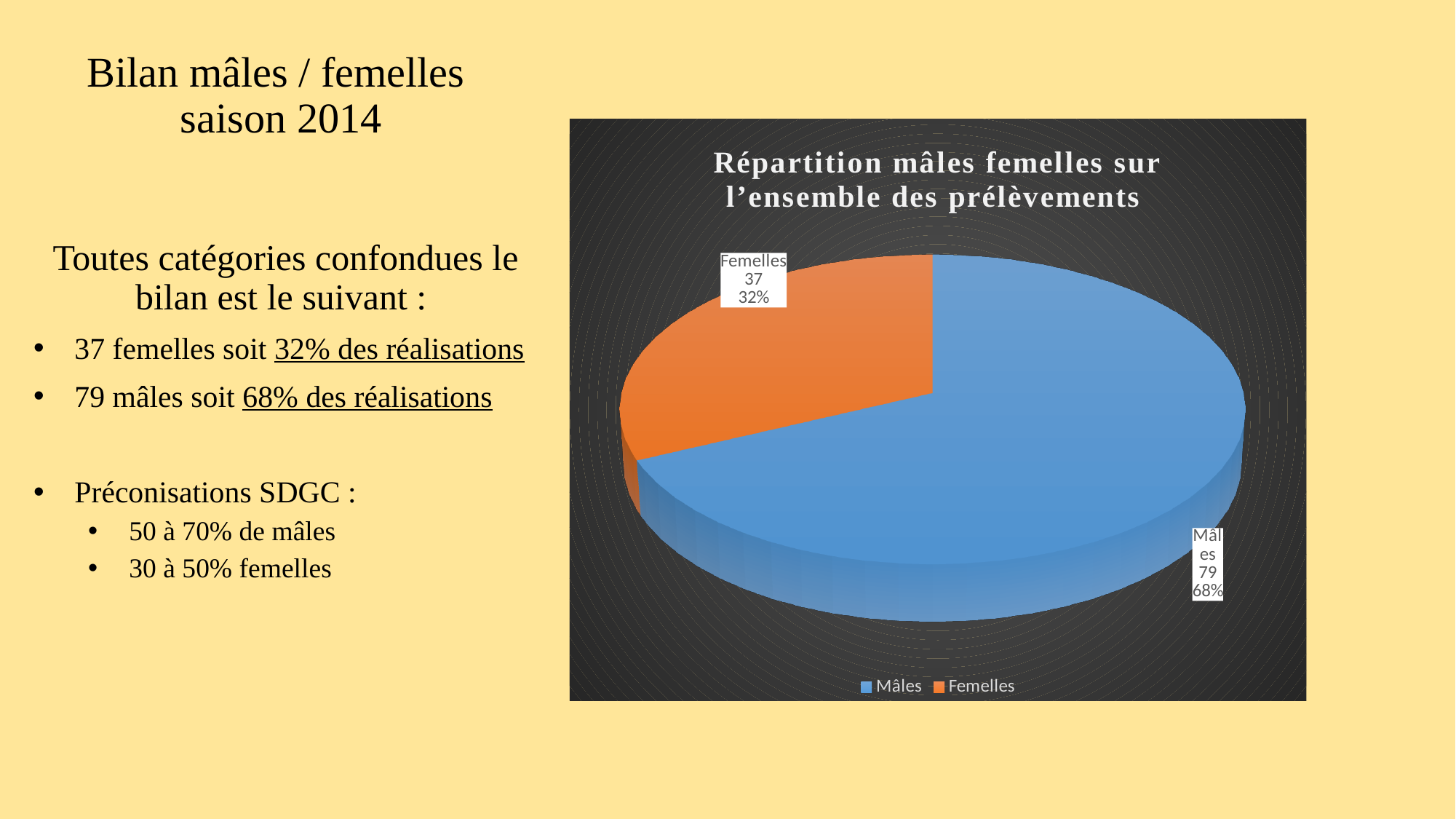
What kind of chart is shown on the slide? pie chart What is the total of the two values shown in the pie chart? 116 What is the title of the pie chart? Répartition mâles femelles sur l'ensemble des prélèvements How many slices does the pie chart have? 2 What share of the pie does the Femelles slice represent? 32% Which category has the largest slice in the pie chart? Mâles What share of the pie does the Mâles slice represent? 68% Which category has the smallest slice in the pie chart? Femelles What is the difference between the Mâles and Femelles values? 42 What is the value for Mâles in the pie chart? 79 Which is larger, the value for Mâles or the value for Femelles? Mâles What is the value for Femelles in the pie chart? 37